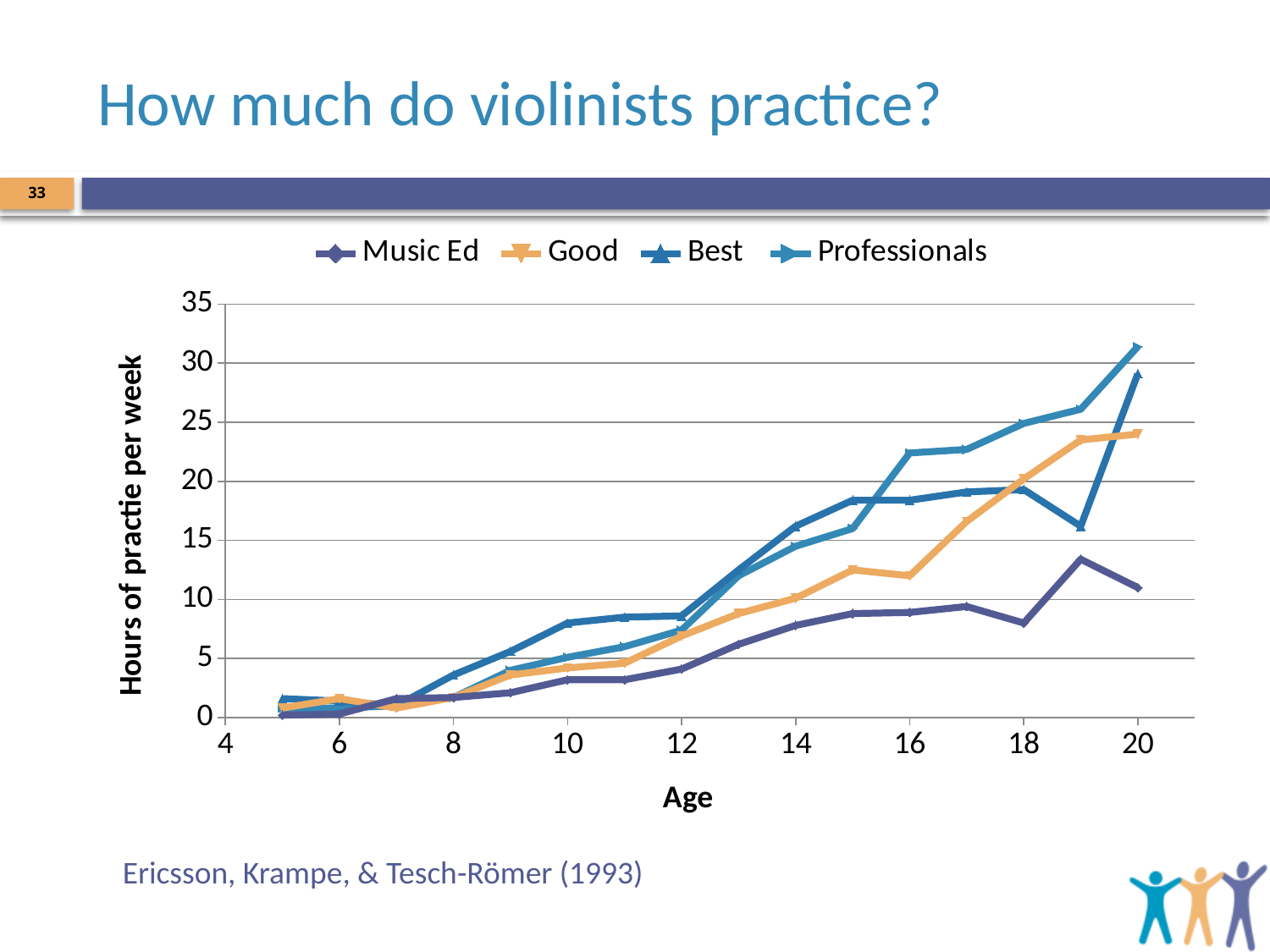
What is the title of the x axis? Age At age 19, which is larger: the value for Good or the value for Best? Good Is the value for Music Ed at age 16 greater or less than 10? less Is the value for Professionals at age 16 greater or less than 20? greater Which series has the highest value at age 20? Professionals What kind of chart is shown on the slide? Line chart Which series has the lowest value at age 20? Music Ed Is the value for Good at age 20 greater or less than 25? less Do the values for Professionals generally rise or fall as age increases? rise At age 20, which is larger: the value for Best or the value for Good? Best How many series does the legend list? 4